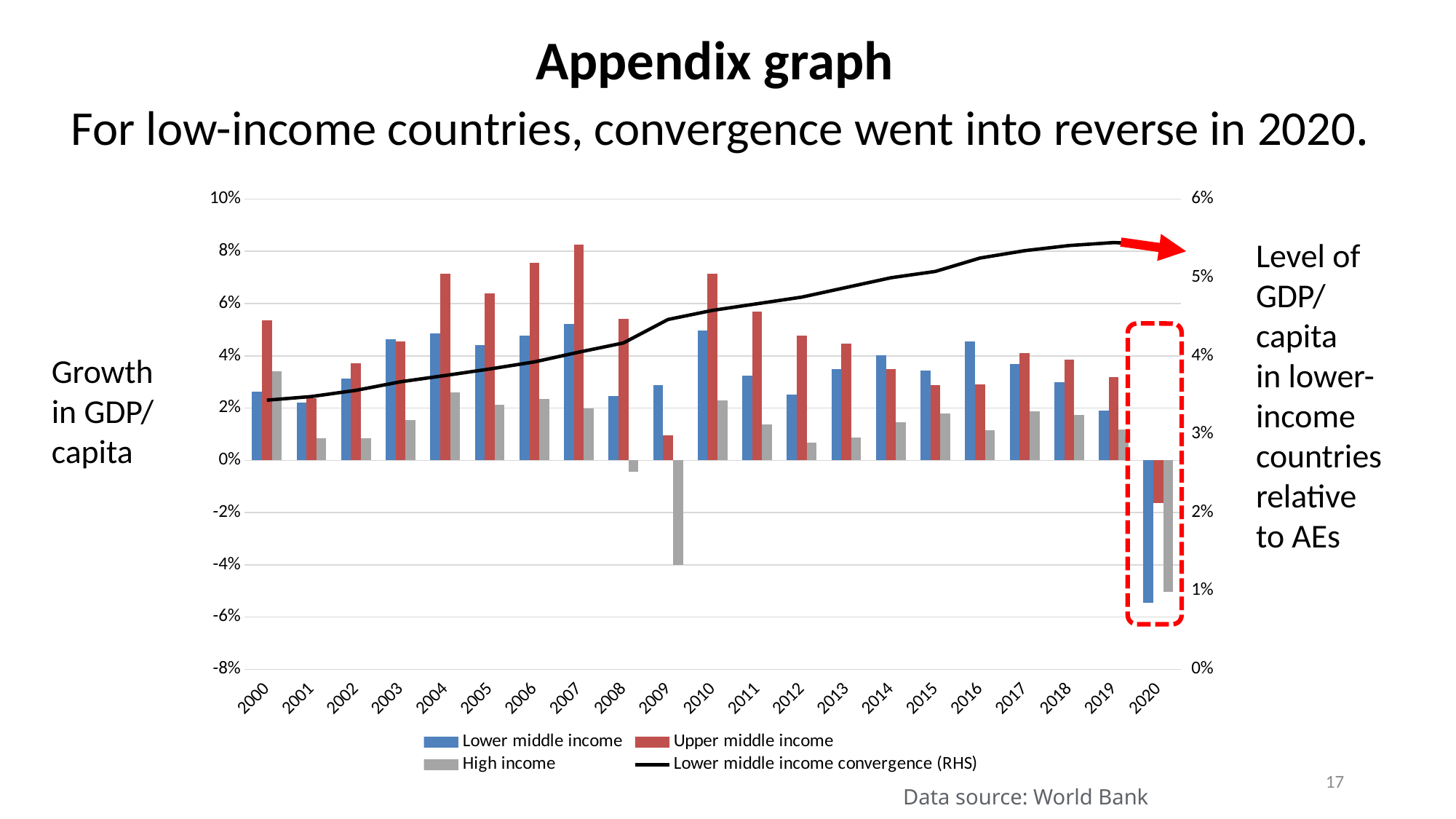
Is the Upper middle income growth value for 2007 greater or less than 6%? greater Is the Lower middle income growth value for 2020 greater or less than -4%? less In which year is the Upper middle income growth bar highest? 2007 What kind of chart is shown on the slide? bar and line chart How many years are shown on the x axis of the chart? 21 In which year is the High income growth bar highest? 2000 Does the Lower middle income convergence line rise or fall from 2000 to 2019? rises Is the High income growth value for 2009 greater or less than -2%? less How many series does the chart's legend list? 4 Which series is plotted on the right-hand axis according to the legend? Lower middle income convergence (RHS) In which year is the Lower middle income growth bar lowest? 2020 In 2009, which is larger: the Lower middle income growth bar or the Upper middle income growth bar? Lower middle income